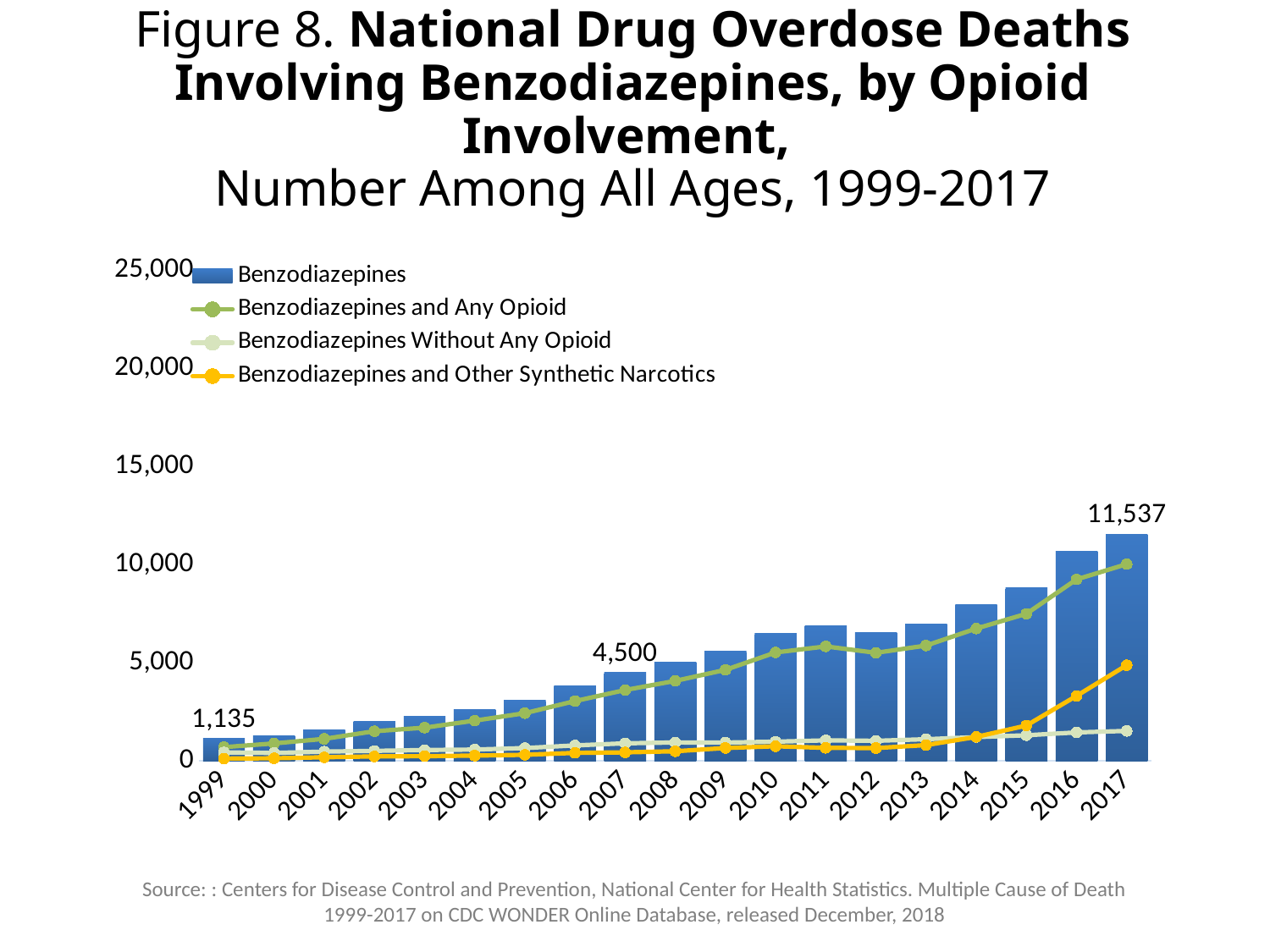
What is the number of benzodiazepine-involved overdose deaths shown for 1999? 1,135 What is the number of benzodiazepine-involved overdose deaths shown for 2017? 11,537 What is the number of benzodiazepine-involved overdose deaths shown for 2007? 4,500 Which series is drawn as a yellow line? Benzodiazepines and Other Synthetic Narcotics Which year has the larger Benzodiazepines value, 2007 or 2017? 2017 How many series does the legend list? 4 Is the Benzodiazepines value for 2015 greater or less than 10,000? less In which year is the Benzodiazepines bar the lowest? 1999 How many years are shown on the x axis? 19 By how much did benzodiazepine-involved deaths increase from 1999 to 2017, using the labelled values? 10,402 In which year is the Benzodiazepines bar the highest? 2017 What is the difference between the labelled Benzodiazepines values for 2017 and 2007? 7,037